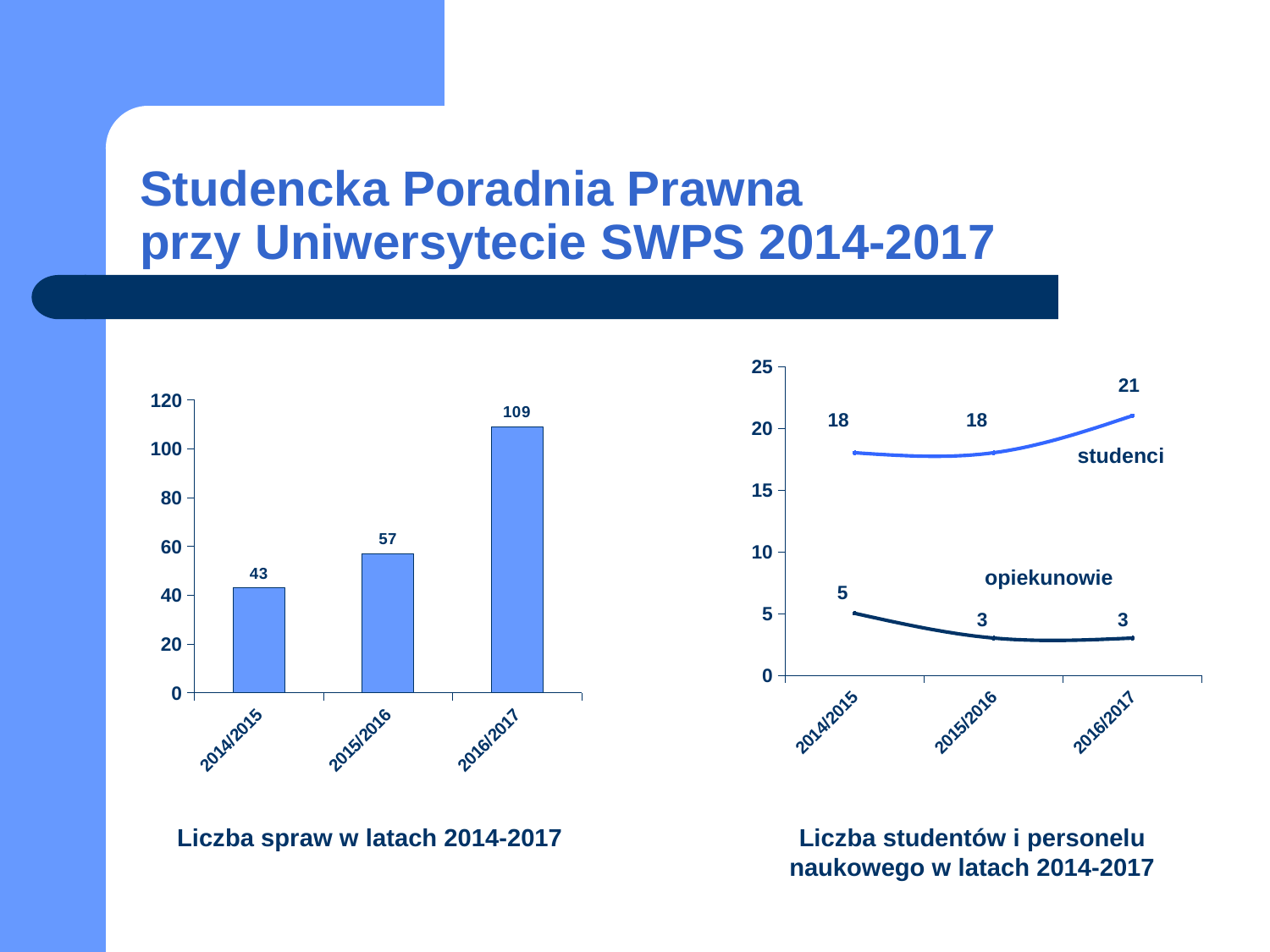
How many series are plotted in the right chart (Liczba studentów i personelu naukowego w latach 2014-2017)? 2 In the left chart (Liczba spraw w latach 2014-2017), do the values rise or fall from 2014/2015 to 2016/2017? rise In the left chart (Liczba spraw w latach 2014-2017), which year has the lowest value? 2014/2015 In the left chart (Liczba spraw w latach 2014-2017), what is the difference between the values for 2016/2017 and 2014/2015? 66 In the left chart (Liczba spraw w latach 2014-2017), which year has the highest value? 2016/2017 What kind of chart is the right chart (Liczba studentów i personelu naukowego w latach 2014-2017)? line chart In the right chart (Liczba studentów i personelu naukowego w latach 2014-2017), what is the value for studenci in 2016/2017? 21 In the right chart (Liczba studentów i personelu naukowego w latach 2014-2017), what is the value for opiekunowie in 2014/2015? 5 In the left chart (Liczba spraw w latach 2014-2017), what is the value for 2015/2016? 57 In the right chart (Liczba studentów i personelu naukowego w latach 2014-2017), what is the difference between studenci and opiekunowie in 2014/2015? 13 In the right chart (Liczba studentów i personelu naukowego w latach 2014-2017), which is larger in 2015/2016: studenci or opiekunowie? studenci What kind of chart is the left chart (Liczba spraw w latach 2014-2017)? bar chart